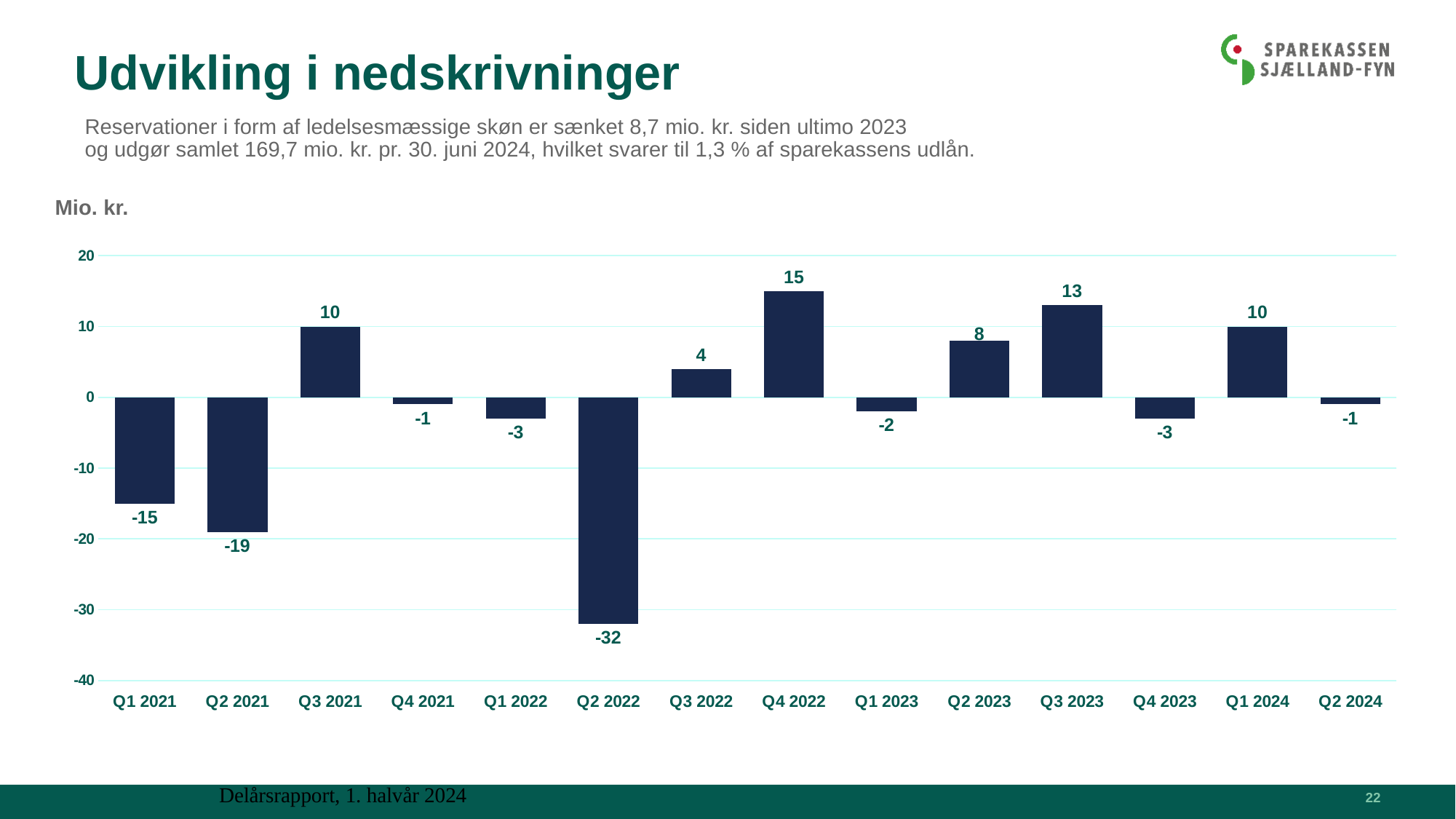
What is the unit label shown above the chart? Mio. kr. Which quarter has the highest value? Q4 2022 What is the value for Q2 2022? -32 Which quarter has the lowest value? Q2 2022 What is the value for Q4 2022? 15 Which is larger, the value for Q3 2021 or the value for Q3 2022? Q3 2021 How many quarters are shown on the x axis? 14 What kind of chart is shown on the slide? Bar chart What is the difference between the values for Q4 2022 and Q3 2023? 2 What is the value for Q2 2024? -1 What is the value for Q2 2023? 8 What is the difference between the values for Q1 2021 and Q2 2021? 4